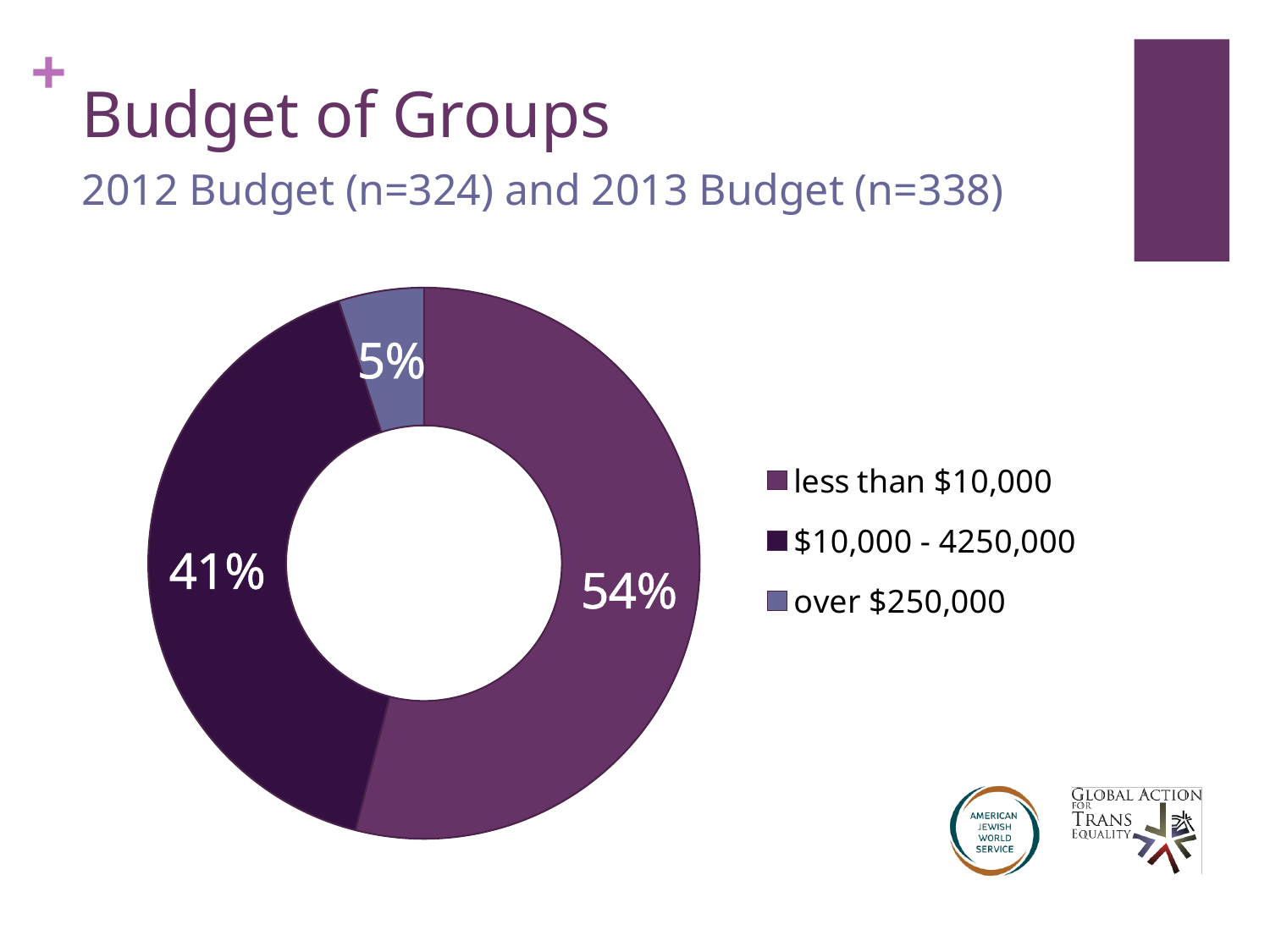
What percentage of groups have a budget of $10,000 - 4250,000? 41% What kind of chart is shown on the slide? pie chart (doughnut) What is the sample size for the 2013 Budget given in the subtitle? n=338 What percentage of groups have a budget over $250,000? 5% What is the title of the slide containing the chart? Budget of Groups What is the difference in percentage points between the 'less than $10,000' and '$10,000 - 4250,000' categories? 13 What is the difference in percentage points between the '$10,000 - 4250,000' and 'over $250,000' categories? 36 Which budget category has the largest share of groups? less than $10,000 Which budget category has the smallest share of groups? over $250,000 Which category has a larger share: 'less than $10,000' or 'over $250,000'? less than $10,000 What percentage of groups have a budget of less than $10,000? 54% How many budget categories are shown in the chart? 3